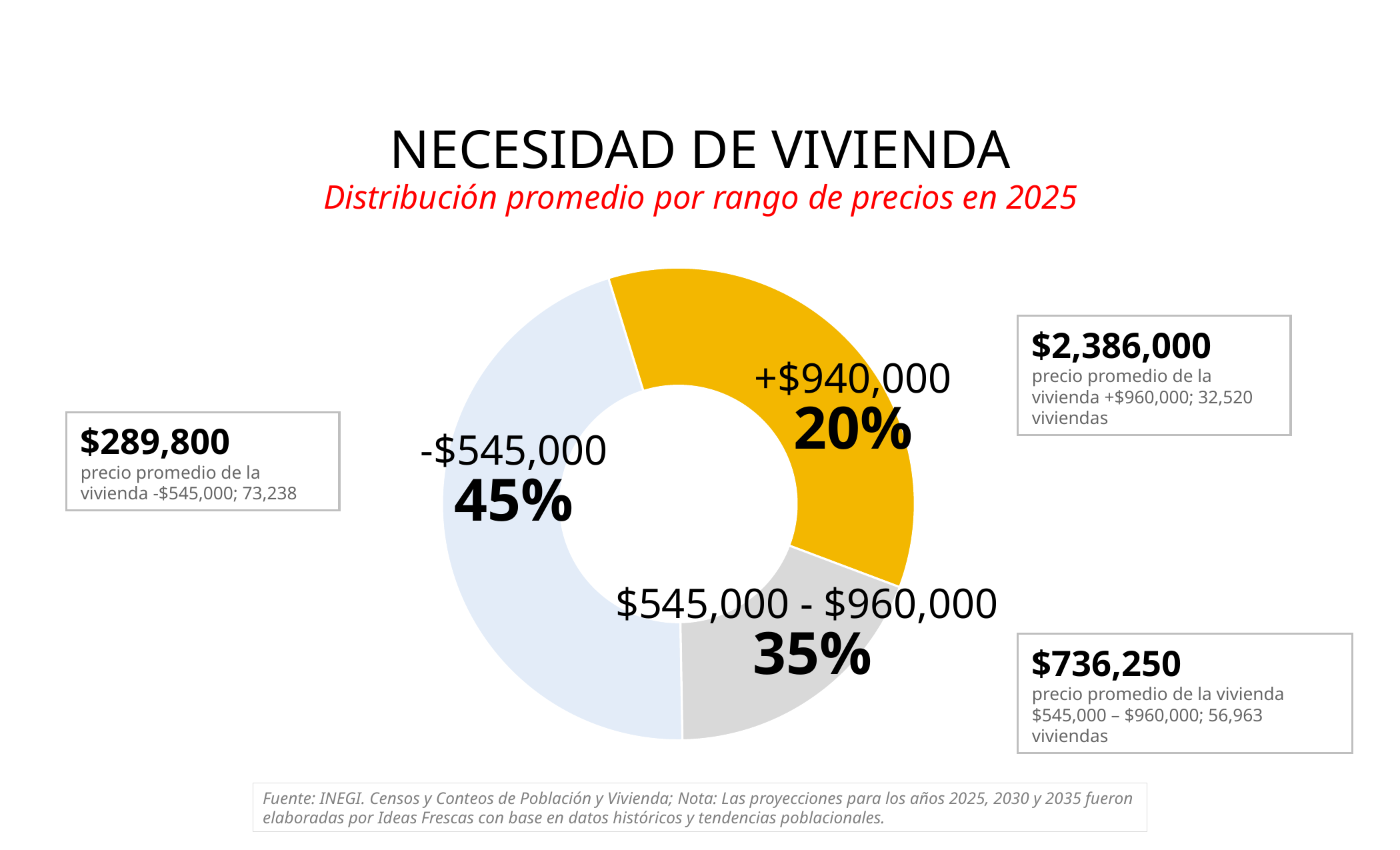
What colour is the slice for the +$940,000 price range? Yellow/orange Which slice is larger: $545,000 - $960,000 or +$940,000? $545,000 - $960,000 What share of the donut chart does the $545,000 - $960,000 price range represent? 35% What is the red subtitle of the chart? Distribución promedio por rango de precios en 2025 What share of the donut chart does the +$940,000 price range represent? 20% What share of the donut chart does the -$545,000 price range represent? 45% How many price ranges are shown in the donut chart? 3 What is the combined share of the $545,000 - $960,000 and +$940,000 slices? 55% Which price range has the smallest share of the donut chart? +$940,000 Which price range has the largest share of the donut chart? -$545,000 What kind of chart is shown on the slide? Donut (pie) chart What is the difference in percentage points between the -$545,000 slice and the +$940,000 slice? 25 percentage points